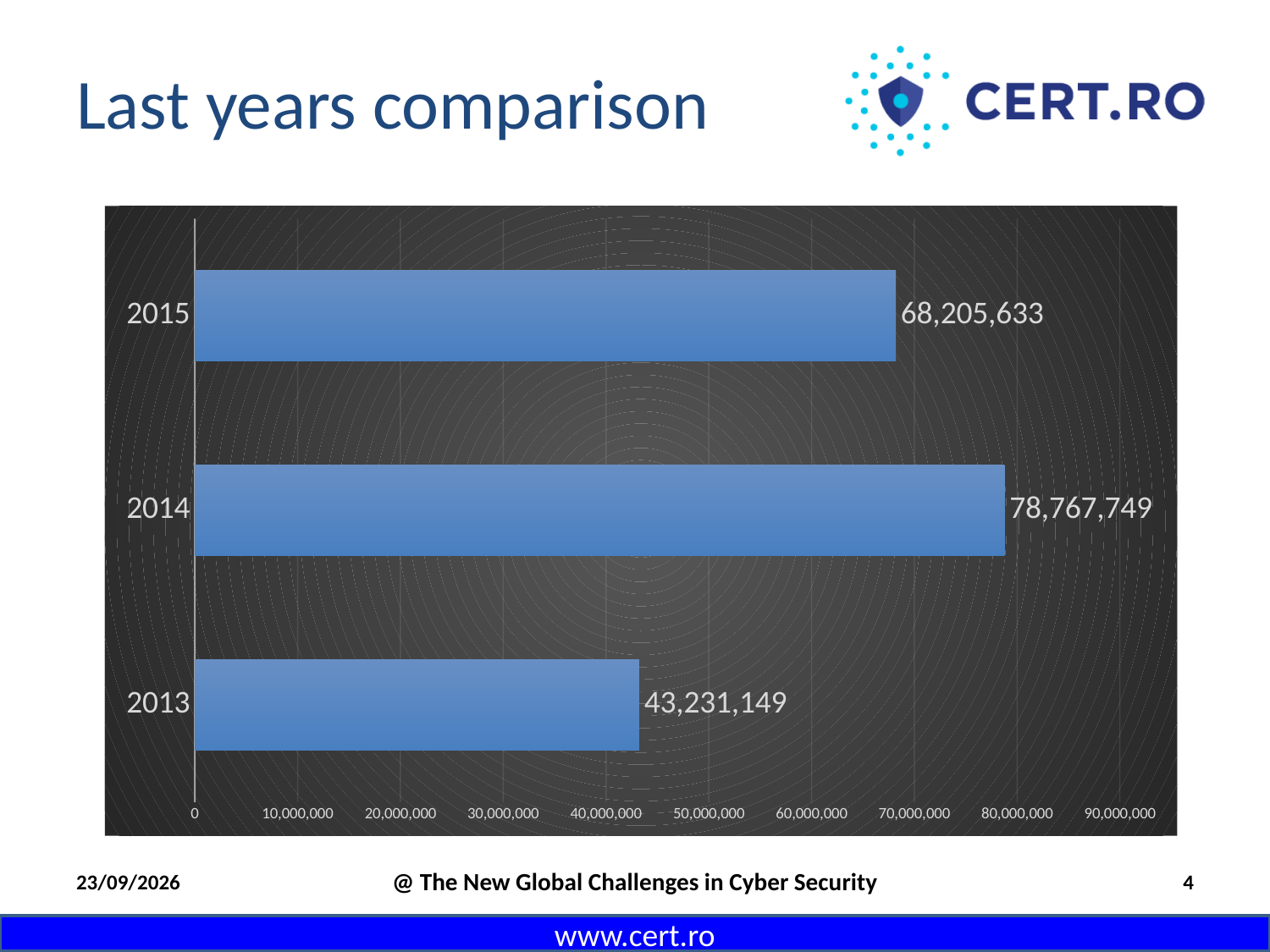
What is the difference between the values for 2015 and 2013? 24,974,484 Which year has the lowest value? 2013 Which year has the highest value? 2014 What is the difference between the values for 2014 and 2015? 10,562,116 What is the value for 2013? 43,231,149 What is the value for 2014? 78,767,749 What kind of chart is shown on the slide? bar chart Is the value for 2013 greater or less than 40,000,000? greater What is the value for 2015? 68,205,633 How many years are shown in the chart? 3 What is the title of the slide containing the chart? Last years comparison Which is larger, the value for 2015 or the value for 2013? 2015